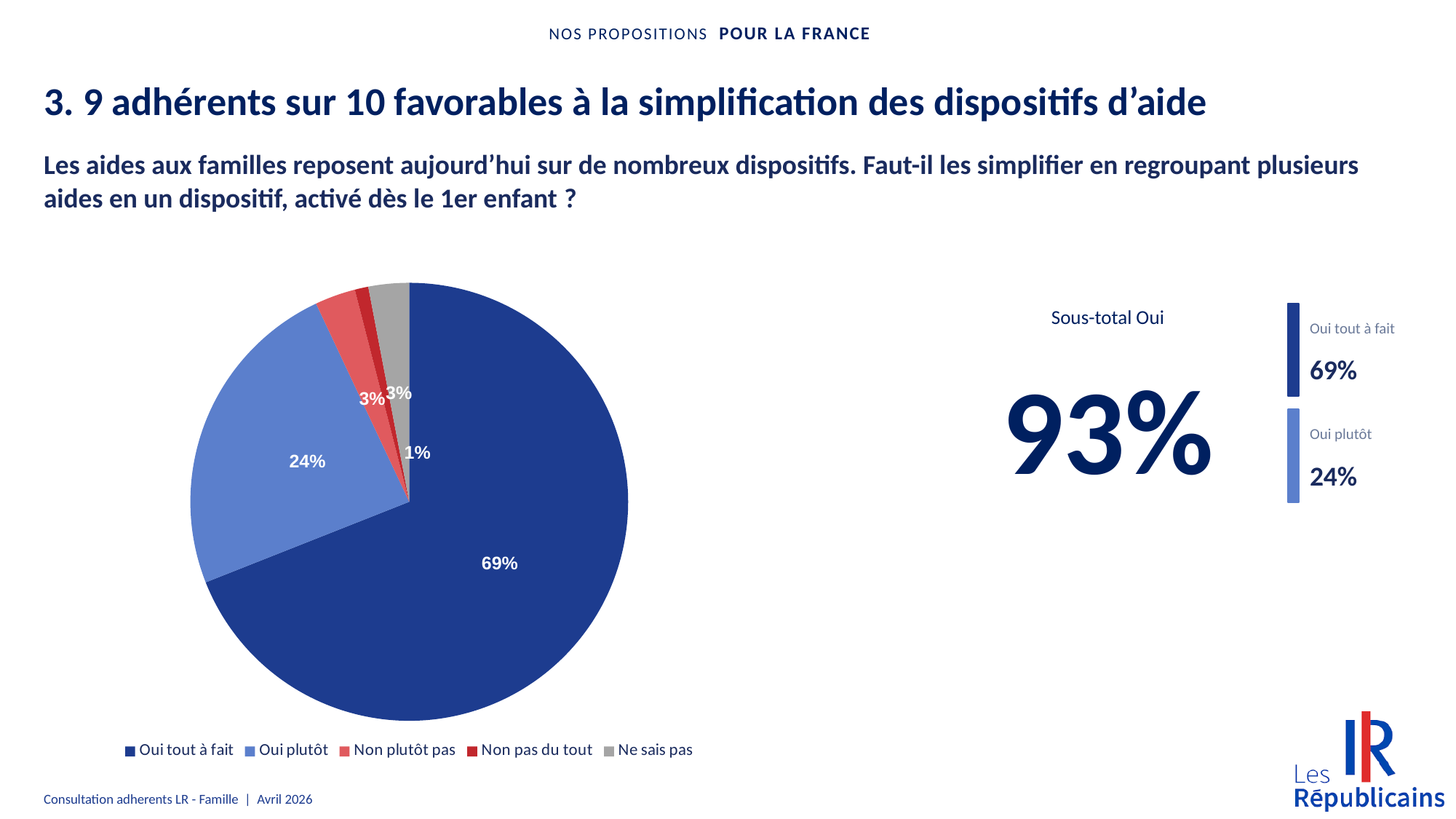
What colour is the "Ne sais pas" slice in the pie chart? Grey What percentage of respondents answered "Oui tout à fait"? 69% What percentage of respondents answered "Non pas du tout"? 1% What is the "Sous-total Oui" value shown on the slide? 93% Which response category has the smallest share of the pie? Non pas du tout What kind of chart is shown on the slide? Pie chart Which response category has the largest share of the pie? Oui tout à fait Which is larger, the share for "Oui plutôt" or the share for "Non plutôt pas"? Oui plutôt What percentage of respondents answered "Ne sais pas"? 3% What percentage of respondents answered "Oui plutôt"? 24% How many response categories does the pie chart show? 5 What is the difference in percentage points between "Oui tout à fait" and "Oui plutôt"? 45